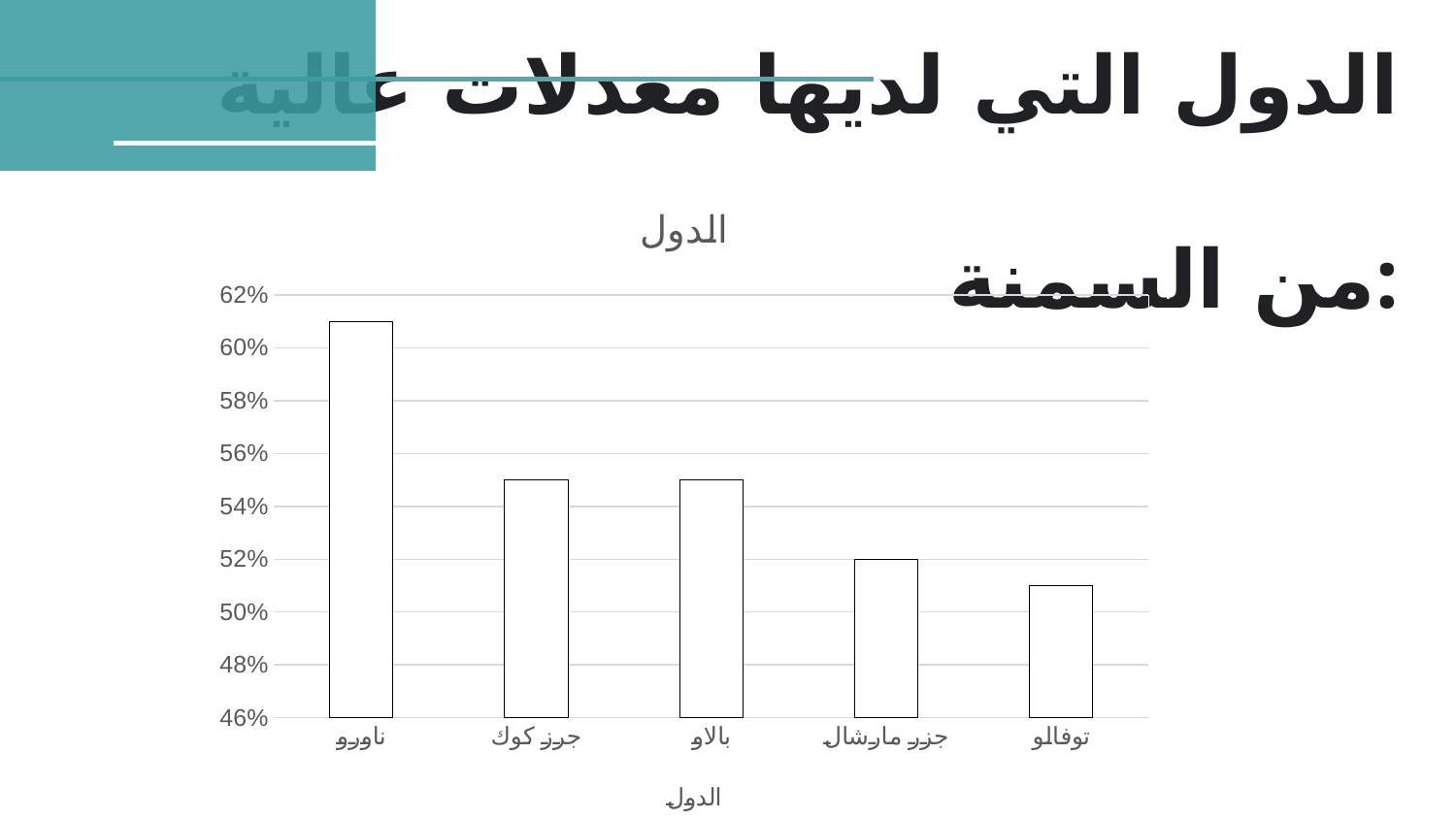
Which country has the lowest bar in the chart? توفالو Is the value for توفالو greater or less than 50%? greater What is the title of the chart? الدول What is the value for جزر مارشال in the chart? 52% Which has a larger value, ناورو or جزر مارشال? ناورو Which country has the highest bar in the chart? ناورو Is the value for ناورو greater or less than 60%? greater Is the value for جزر كوك greater or less than 56%? less Do the values rise or fall from left to right along the x axis? fall How many countries are shown on the x axis of the chart? 5 What kind of chart is shown on the slide? bar chart